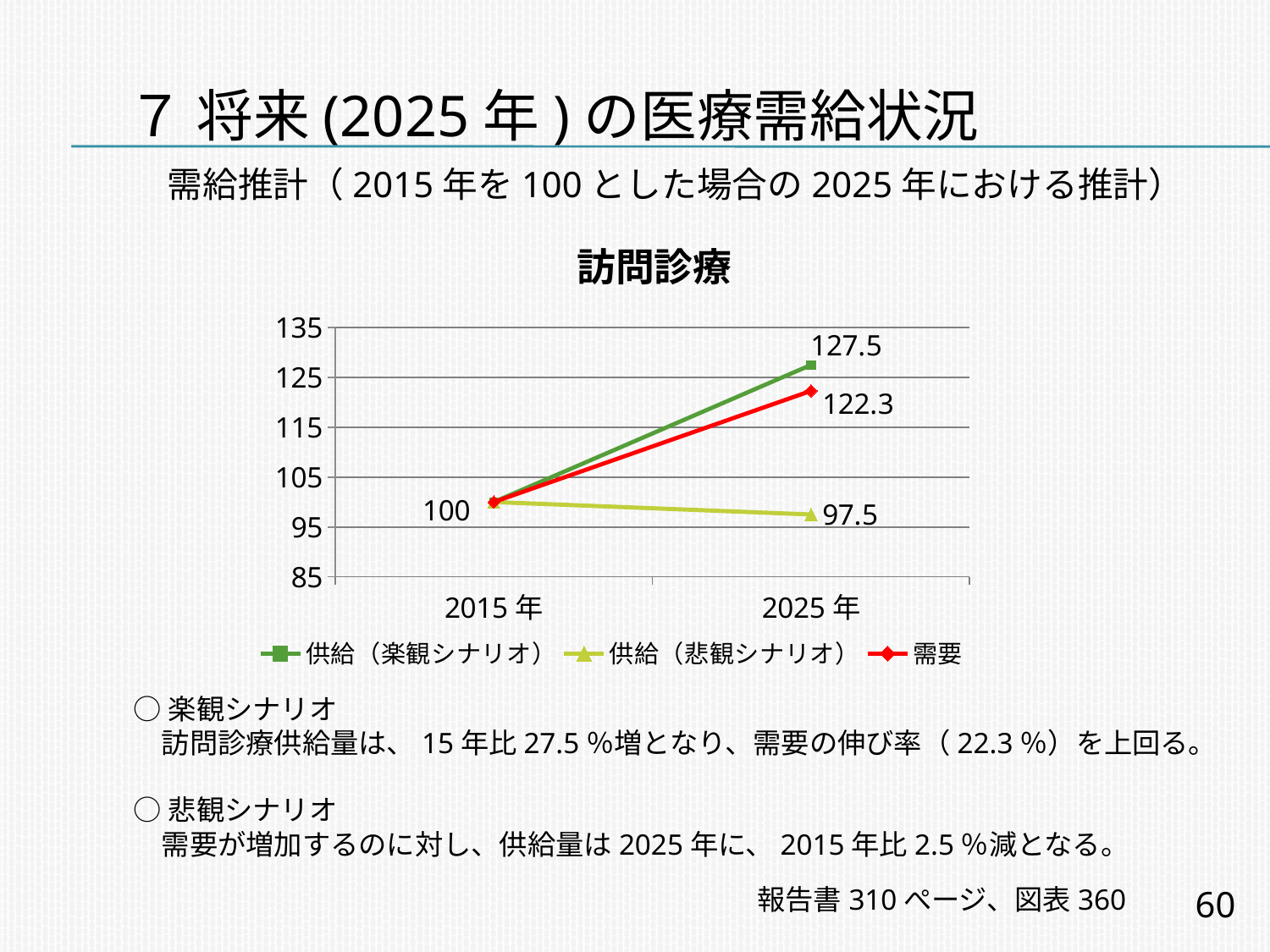
What is the value of 供給（悲観シナリオ） in 2025年? 97.5 What is the value of all three series in 2015年? 100 What is the title of the chart? 訪問診療 What is the difference between 供給（楽観シナリオ） and 需要 in 2025年? 5.2 What is the value of 需要 in 2025年? 122.3 Which series has the highest value in 2025年? 供給（楽観シナリオ） Does the 供給（悲観シナリオ） series rise or fall from 2015年 to 2025年? fall Which series has the lowest value in 2025年? 供給（悲観シナリオ） Which is larger in 2025年, 需要 or 供給（悲観シナリオ）? 需要 What kind of chart is shown? line chart How many series does the legend list? 3 What is the value of 供給（楽観シナリオ） in 2025年? 127.5